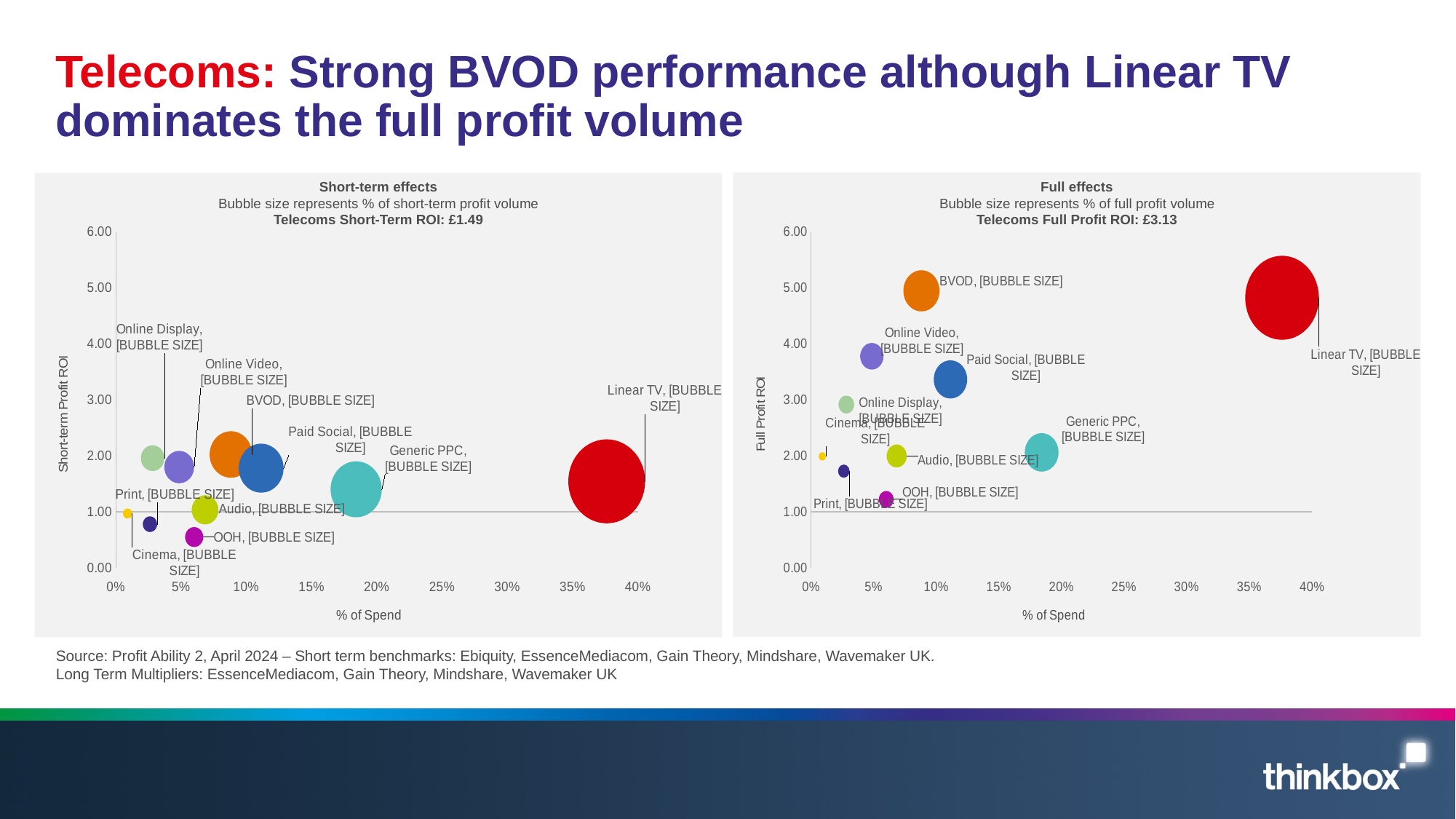
In the 'Short-term effects' chart, which has the higher short-term profit ROI, Audio or Cinema? Audio In the 'Full effects' chart, which channel has the lowest full profit ROI? OOH What type of chart is the 'Short-term effects' chart? Bubble chart In the 'Full effects' chart, which has the higher full profit ROI, Online Video or Paid Social? Online Video In the 'Short-term effects' chart, how many media channels are plotted as bubbles? 10 In the 'Full effects' chart, is the full profit ROI for Paid Social greater or less than 3.00? greater In the 'Short-term effects' chart, which channel has the lowest short-term profit ROI? OOH In the 'Full effects' chart, is the full profit ROI for BVOD greater or less than 4.00? greater In the 'Short-term effects' chart, is the short-term profit ROI for OOH greater or less than 1.00? less What is the Telecoms Full Profit ROI stated in the 'Full effects' chart title? £3.13 In the 'Full effects' chart, which channel has the highest % of spend? Linear TV